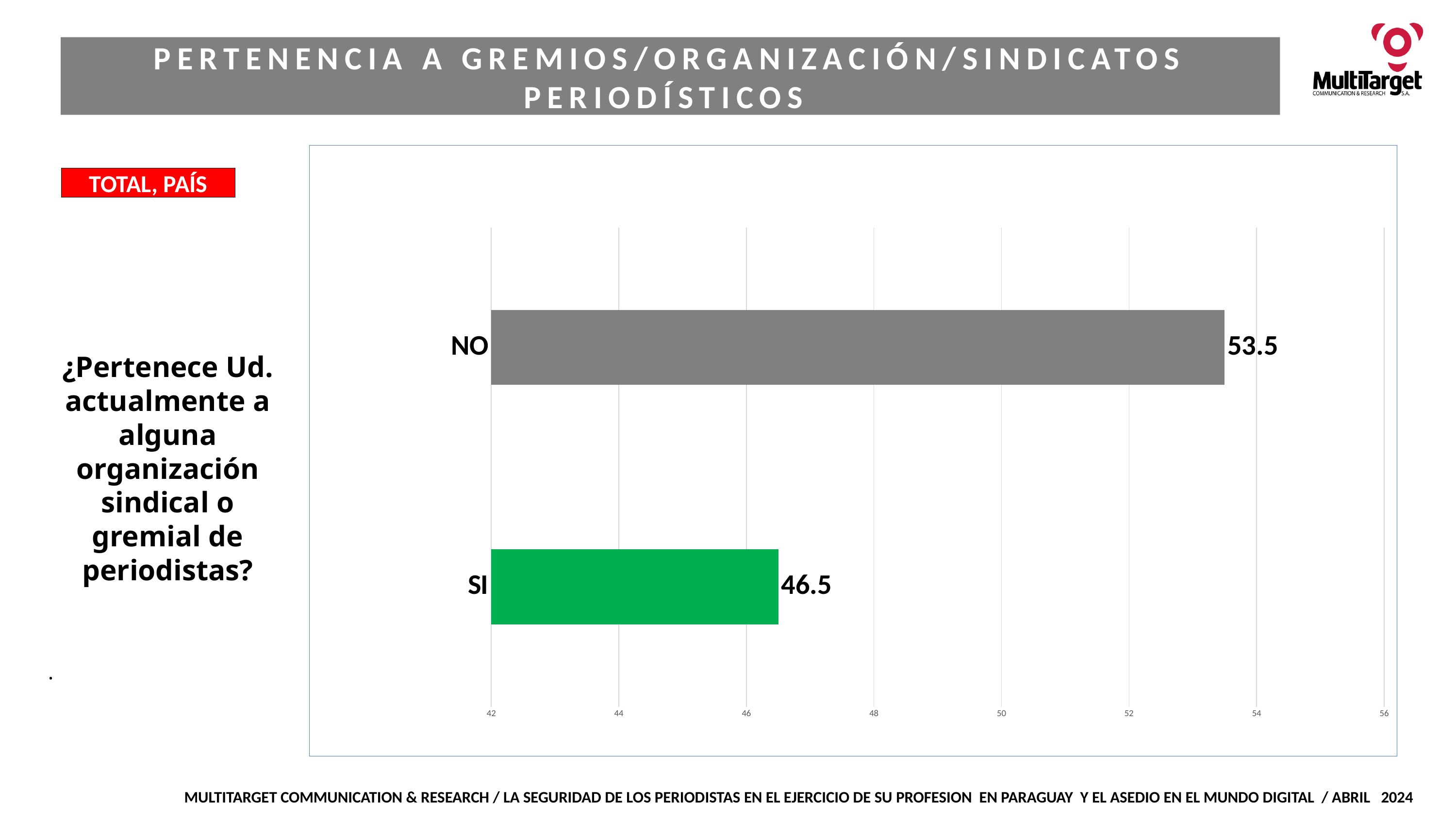
What is the value for NO? 53.5 How many categories are shown in the chart? 2 Which category has the lowest value? SI What is the value for SI? 46.5 What is the label in the red box above the chart? TOTAL, PAÍS Is the value for SI greater or less than 48? less What kind of chart is shown on the slide? bar chart What colour is the bar for SI? green Is the value for NO greater or less than 52? greater What is the difference between the values for NO and SI? 7 Which is larger, the value for NO or the value for SI? NO Which category has the highest value? NO